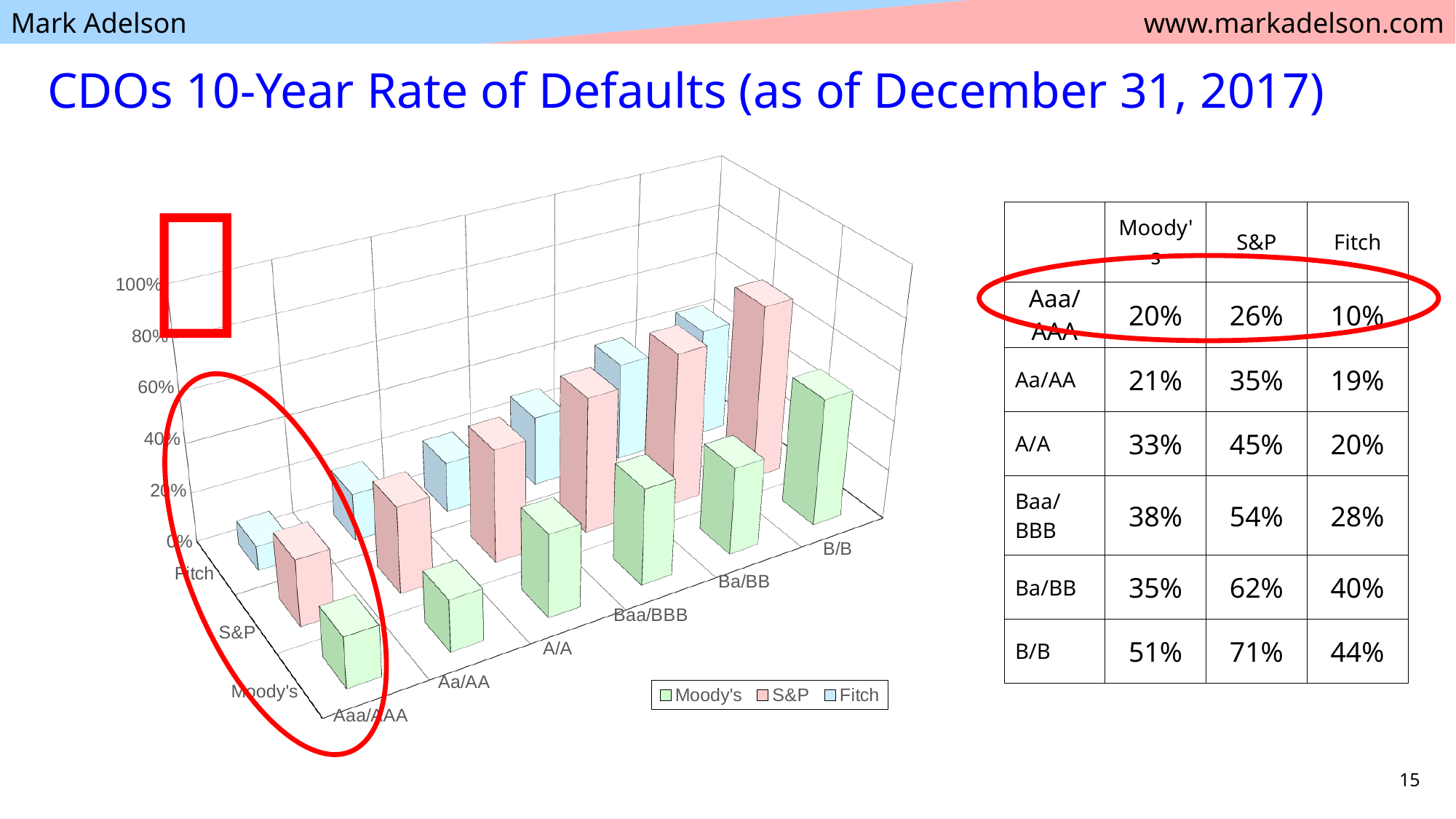
Which rating category has the highest S&P default rate? B/B For the B/B category, how much higher is the S&P default rate than the Moody's default rate? 20% Which rating category has the lowest Fitch default rate? Aaa/AAA How many series does the chart legend list? 3 How many rating categories are shown on the chart's category axis? 6 Which colour represents the Moody's series in the chart legend? green For Moody's, which category has the larger default rate: Baa/BBB or Ba/BB? Baa/BBB Is the S&P default rate for B/B greater or less than 60%? greater What is the Fitch 10-year default rate for the Aaa/AAA rating category? 10% Do the S&P default rates rise or fall as the rating categories move from Aaa/AAA to B/B? rise What kind of chart is shown on the slide? bar chart What is the S&P 10-year default rate for the Ba/BB rating category? 62%